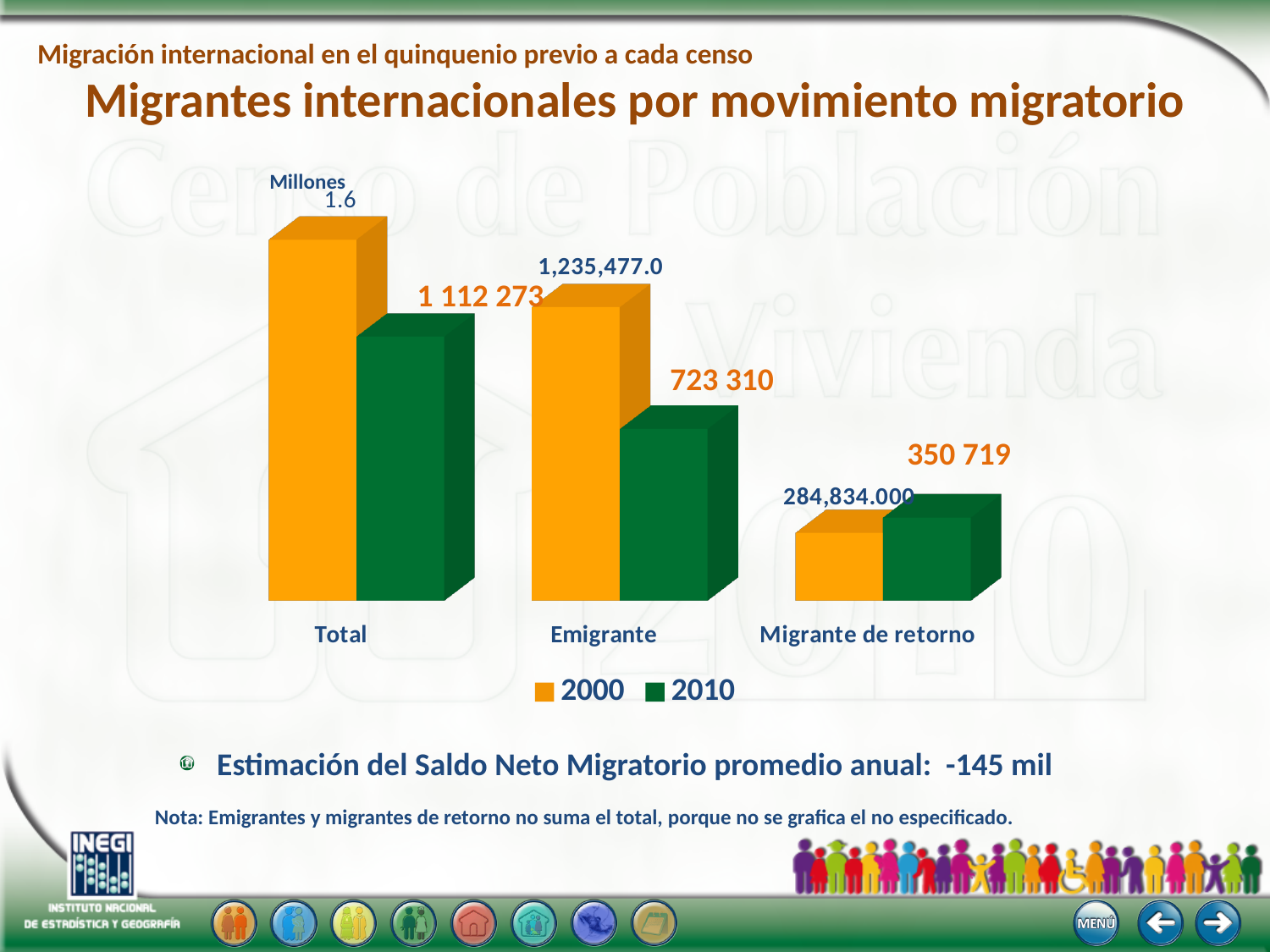
What is the value for Migrante de retorno in 2010? 350 719 What is the value for Emigrante in 2000? 1,235,477.0 How many categories are shown on the x axis? 3 Which category has the highest value for the 2010 series? Total For Migrante de retorno, which year has the larger value, 2000 or 2010? 2010 What is the value for Emigrante in 2010? 723 310 What is the value for Migrante de retorno in 2000? 284,834.000 What kind of chart is shown on the slide? Bar chart What is the value for Total in 2000? 1.6 Which category has the lowest value for the 2000 series? Migrante de retorno How many series does the legend list? 2 What is the value for Total in 2010? 1 112 273